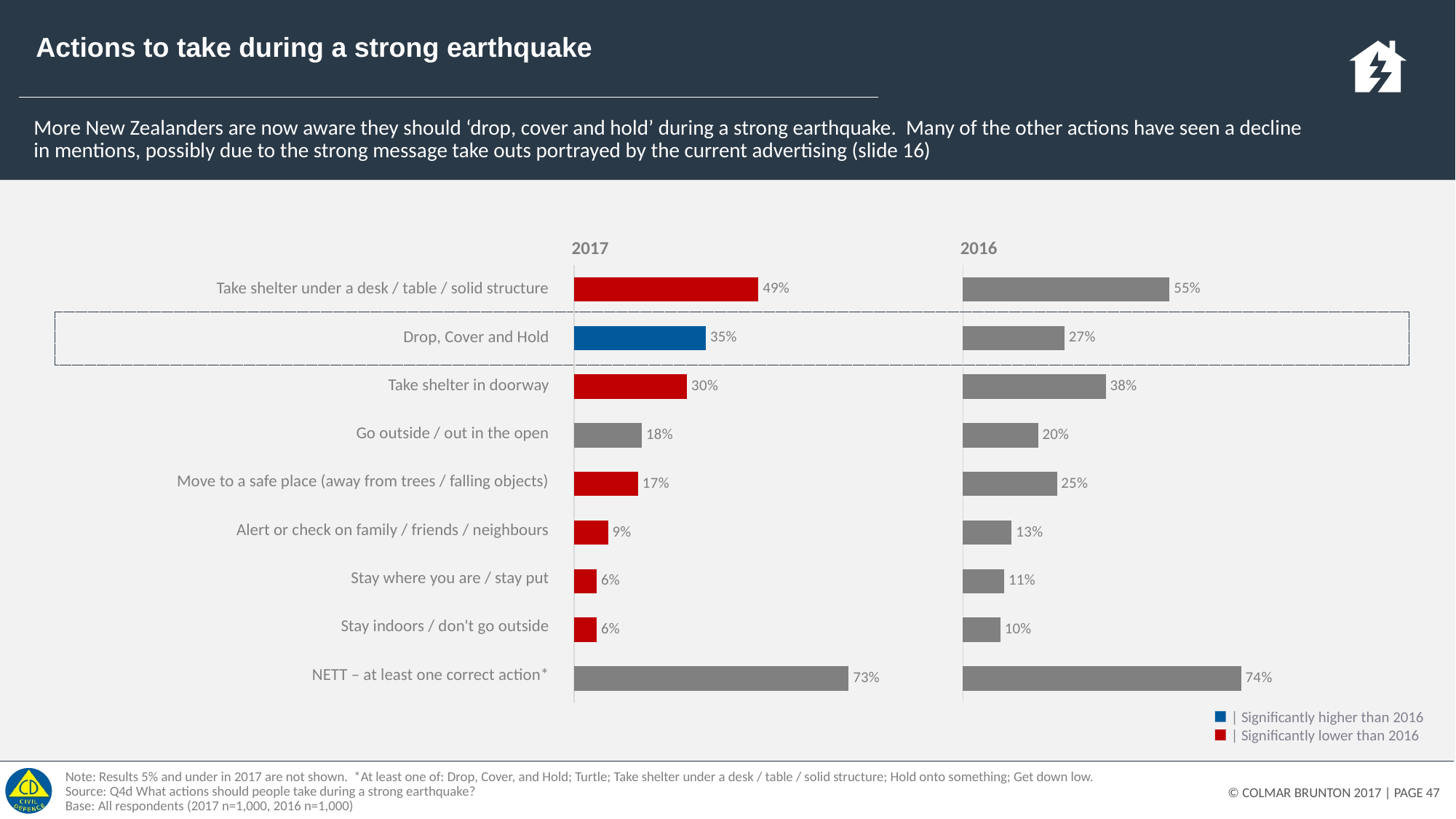
What is the difference between the 2016 and 2017 values for 'Take shelter under a desk / table / solid structure'? 6 percentage points In the 2017 chart, what is the value for 'NETT – at least one correct action*'? 73% What type of chart is used to show the 2017 and 2016 results? Bar chart What is the difference between the 2017 and 2016 values for 'Drop, Cover and Hold'? 8 percentage points In the 2016 chart, what percentage is shown for 'Take shelter in doorway'? 38% In the 2017 chart, which action is shown with a blue bar? Drop, Cover and Hold According to the legend, what does a blue bar indicate? Significantly higher than 2016 In the 2017 chart, what percentage is shown for 'Drop, Cover and Hold'? 35% In the 2016 chart, which action has the lowest percentage? Stay indoors / don't go outside Is the 2017 value for 'Take shelter in doorway' larger or smaller than the 2016 value? smaller In the 2016 chart, which action (excluding the NETT row) has the highest percentage? Take shelter under a desk / table / solid structure How many action categories (including the NETT row) are listed in the charts? 9